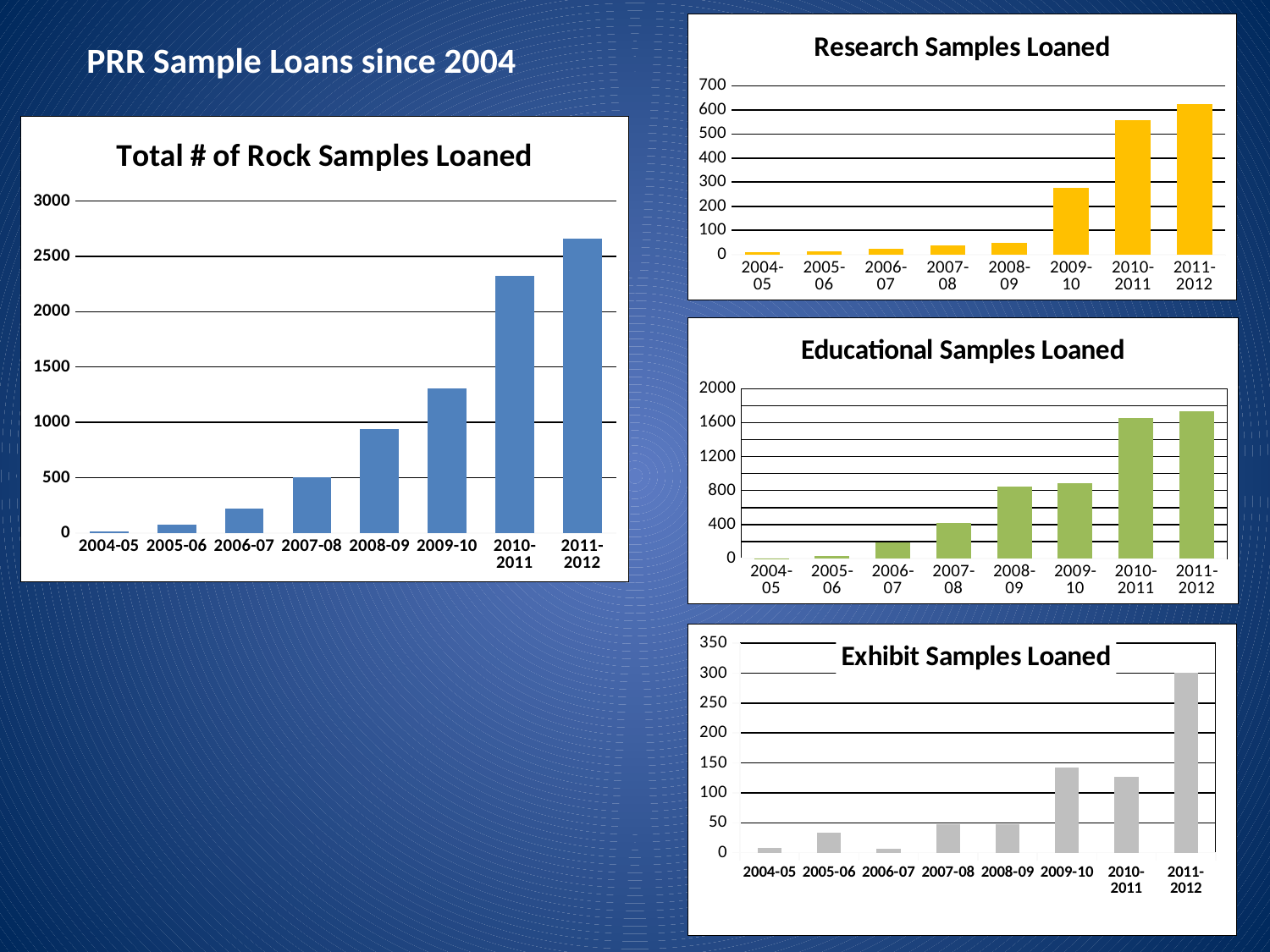
In the 'Educational Samples Loaned' chart, which is larger, the value for 2009-10 or the value for 2010-2011? 2010-2011 In the 'Total # of Rock Samples Loaned' chart, do the values generally rise or fall from 2004-05 to 2011-2012? rise In the 'Research Samples Loaned' chart, which year has the highest value? 2011-2012 In the 'Total # of Rock Samples Loaned' chart, is the value for 2008-09 greater or less than 1000? less In the 'Total # of Rock Samples Loaned' chart, is the value for 2010-2011 greater or less than 2000? greater How many years are shown on the x axis of the 'Research Samples Loaned' chart? 8 In the 'Educational Samples Loaned' chart, is the value for 2006-07 greater or less than 400? less In the 'Total # of Rock Samples Loaned' chart, which year has the lowest value? 2004-05 In the 'Exhibit Samples Loaned' chart, which is larger, the value for 2009-10 or the value for 2010-2011? 2009-10 What kind of chart is the 'Exhibit Samples Loaned' chart? bar chart In the 'Total # of Rock Samples Loaned' chart, which year has the highest value? 2011-2012